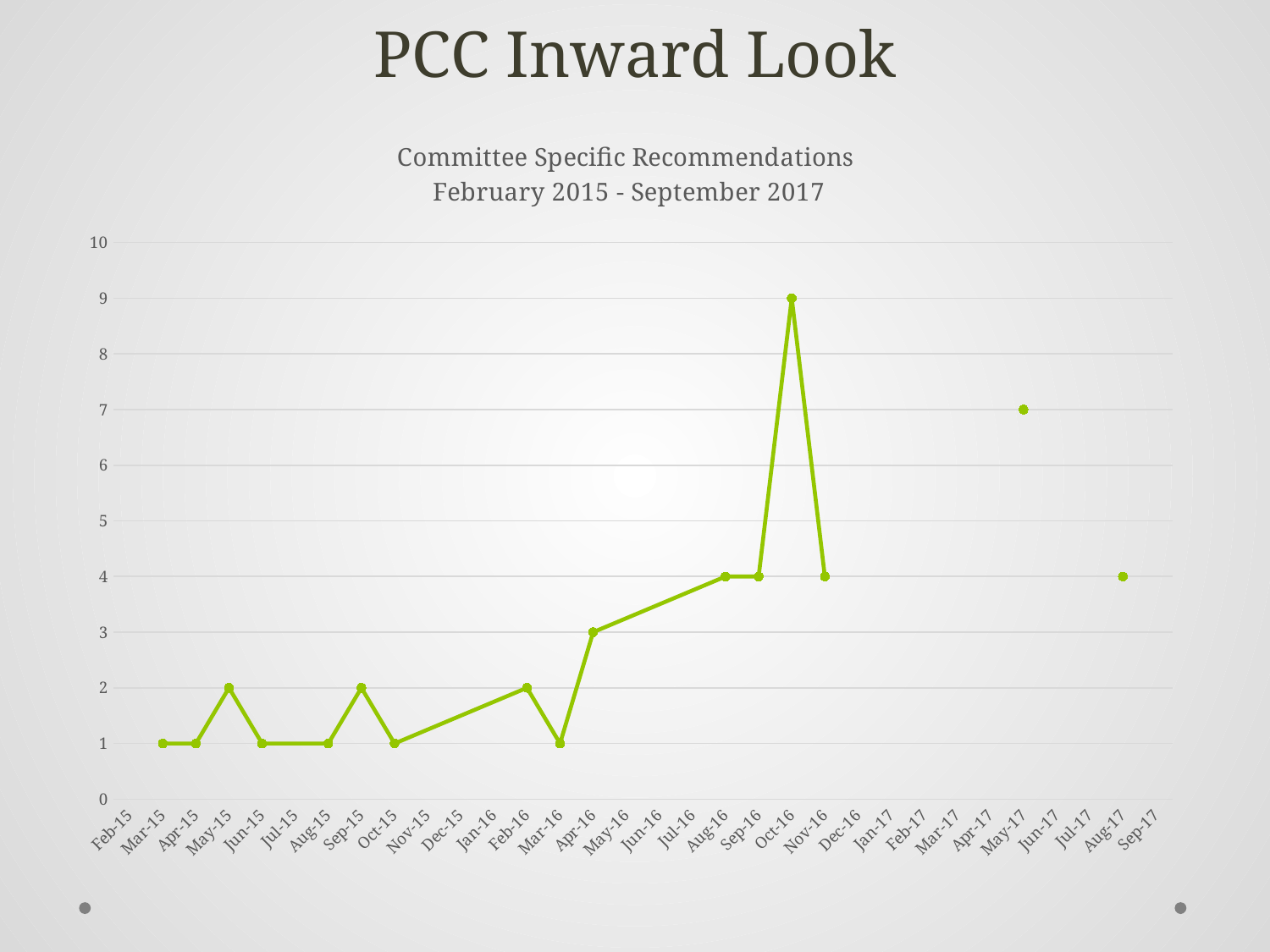
How many month labels are shown on the x axis? 32 What is the value for Oct-16? 9 What is the value for May-17? 7 What is the value for Aug-17? 4 What is the value for Apr-16? 3 Is the value for Oct-16 greater or less than 8? greater Which month has the highest value? Oct-16 What is the highest value shown on the y axis? 10 What is the difference between the values for Oct-16 and Nov-16? 5 Which is larger, the value for May-15 or the value for Apr-16? Apr-16 What is the subtitle of the chart? Committee Specific Recommendations February 2015 - September 2017 What type of chart is shown on the slide? Line chart